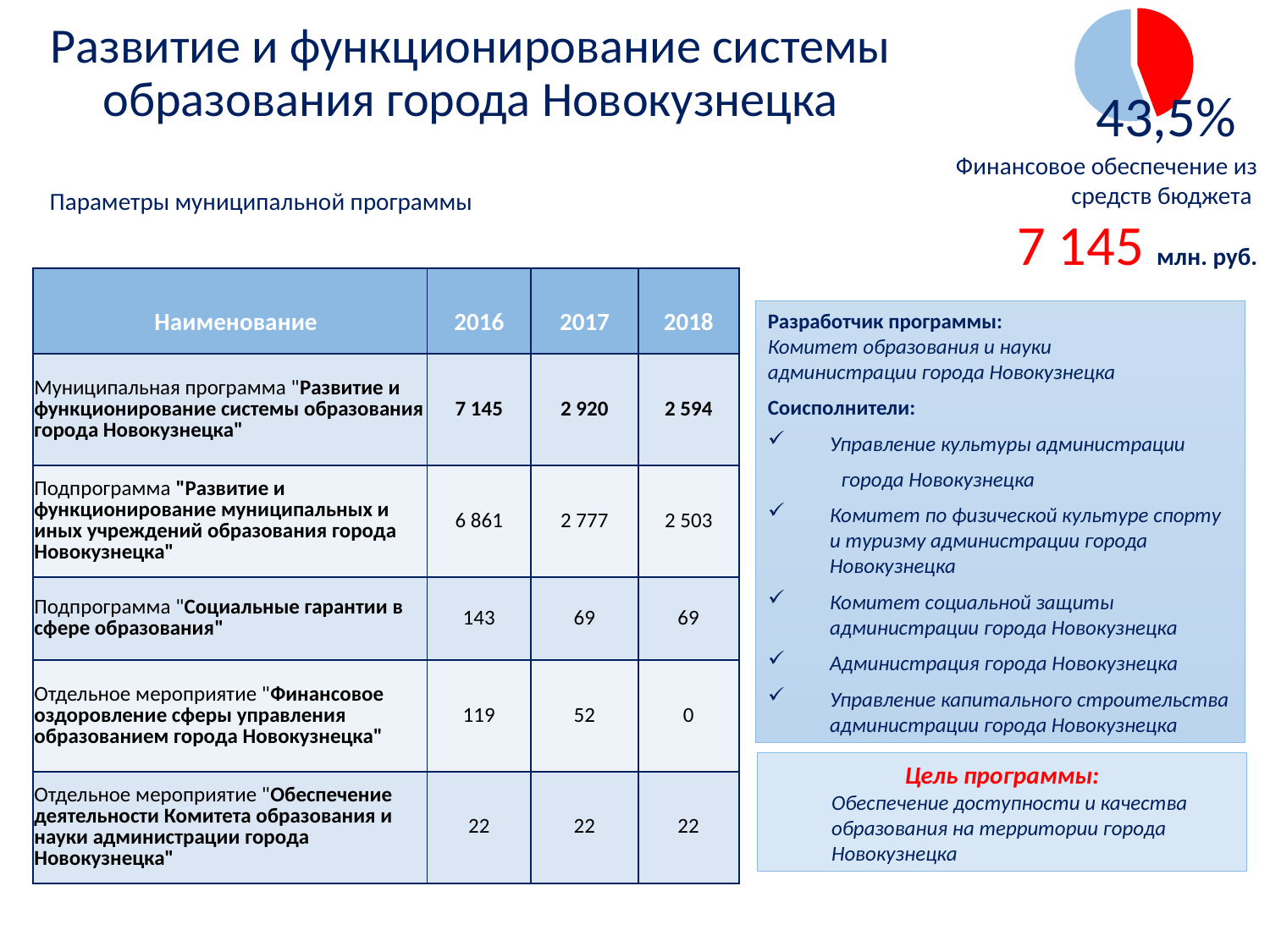
Which slice of the pie chart is larger, the red one or the light blue one? the light blue one What colour is the slice of the pie chart labelled 43,5%? red How many slices does the pie chart in the top right corner have? 2 What kind of chart is shown in the top right corner of the slide? pie chart What amount in млн. руб. is printed below the pie chart next to the text "Финансовое обеспечение из средств бюджета"? 7 145 млн. руб. What share is printed on the red slice of the pie chart? 43,5%